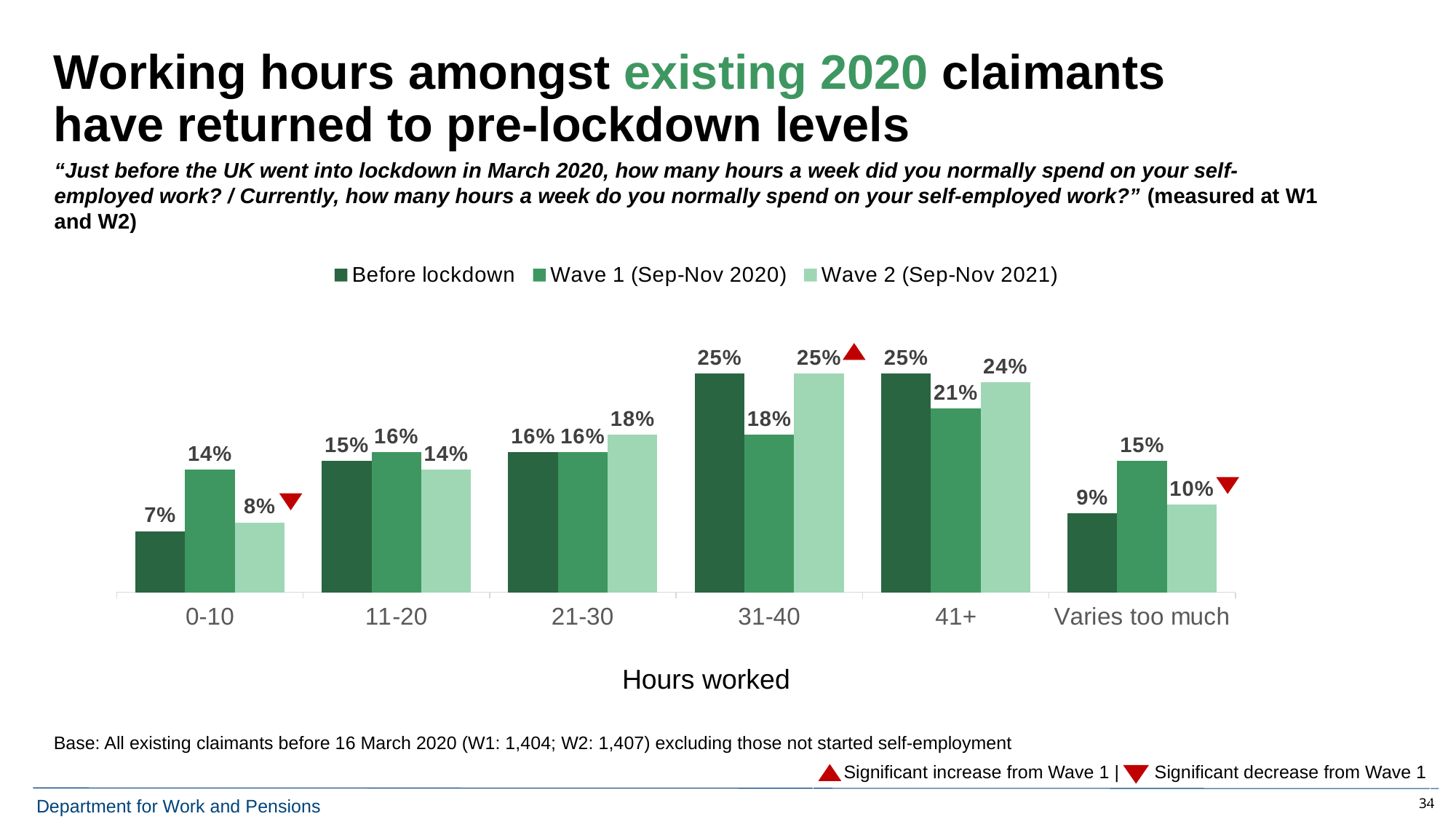
Which is larger for the Varies too much category: the Wave 1 value or the Wave 2 value? Wave 1 (Sep-Nov 2020) Which category has the highest Wave 1 (Sep-Nov 2020) value? 41+ How many hours-worked categories are shown on the x axis? 6 What kind of chart is shown on the slide? Bar chart What is the difference between the Wave 1 and Wave 2 values for the 31-40 hours category? 7% How many series does the legend list? 3 Which category has the lowest Before lockdown value? 0-10 Which categories are marked with a red downward triangle indicating a significant decrease from Wave 1? 0-10 and Varies too much What is the Before lockdown value for the 41+ hours category? 25% What is the Wave 2 (Sep-Nov 2021) value for the 21-30 hours category? 18% What is the x-axis title of the chart? Hours worked What is the Wave 1 (Sep-Nov 2020) value for the 0-10 hours category? 14%